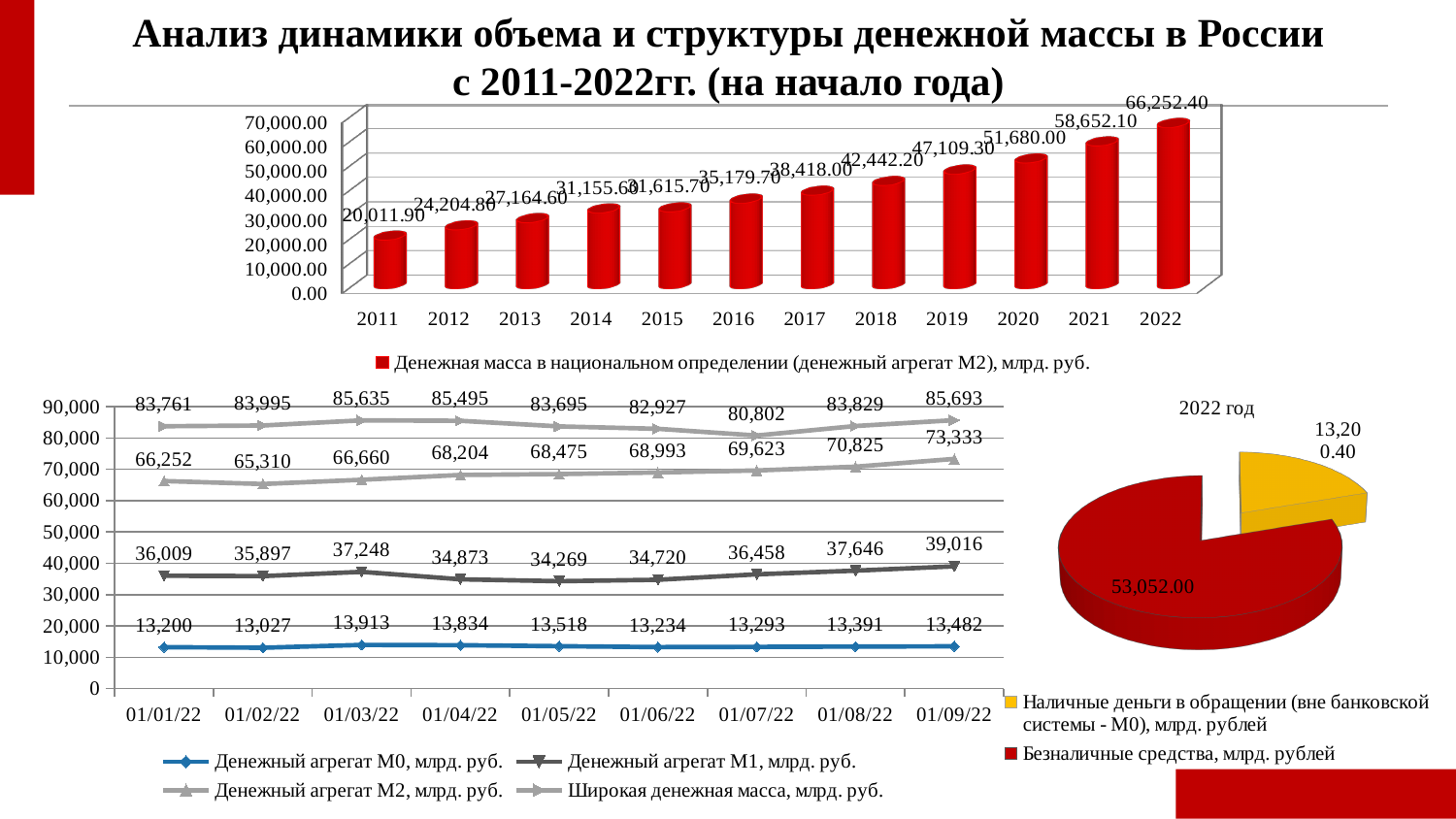
In the bottom-left line chart, on which date is Денежный агрегат М0 lowest? 01/02/22 In the top bar chart, what is the value for 2011? 20,011.90 In the top bar chart, what is the value for 2022? 66,252.40 In the top bar chart, how many years are shown? 12 In the bottom-left line chart, which is larger on 01/05/22: Денежный агрегат М2 or Широкая денежная масса? Широкая денежная масса In the bottom-left line chart, what is the value of Широкая денежная масса on 01/07/22? 80,802 In the top bar chart, what is the difference between the values for 2022 and 2021? 7,600.30 In the bottom-left line chart, what is the value of Денежный агрегат М1 on 01/09/22? 39,016 In the bottom-left line chart, how many series does the legend list? 4 In the top bar chart, do the values rise or fall from 2011 to 2022? rise In the pie chart titled 2022 год, what is the value for Безналичные средства? 53,052.00 In the top bar chart, which year has the highest value? 2022